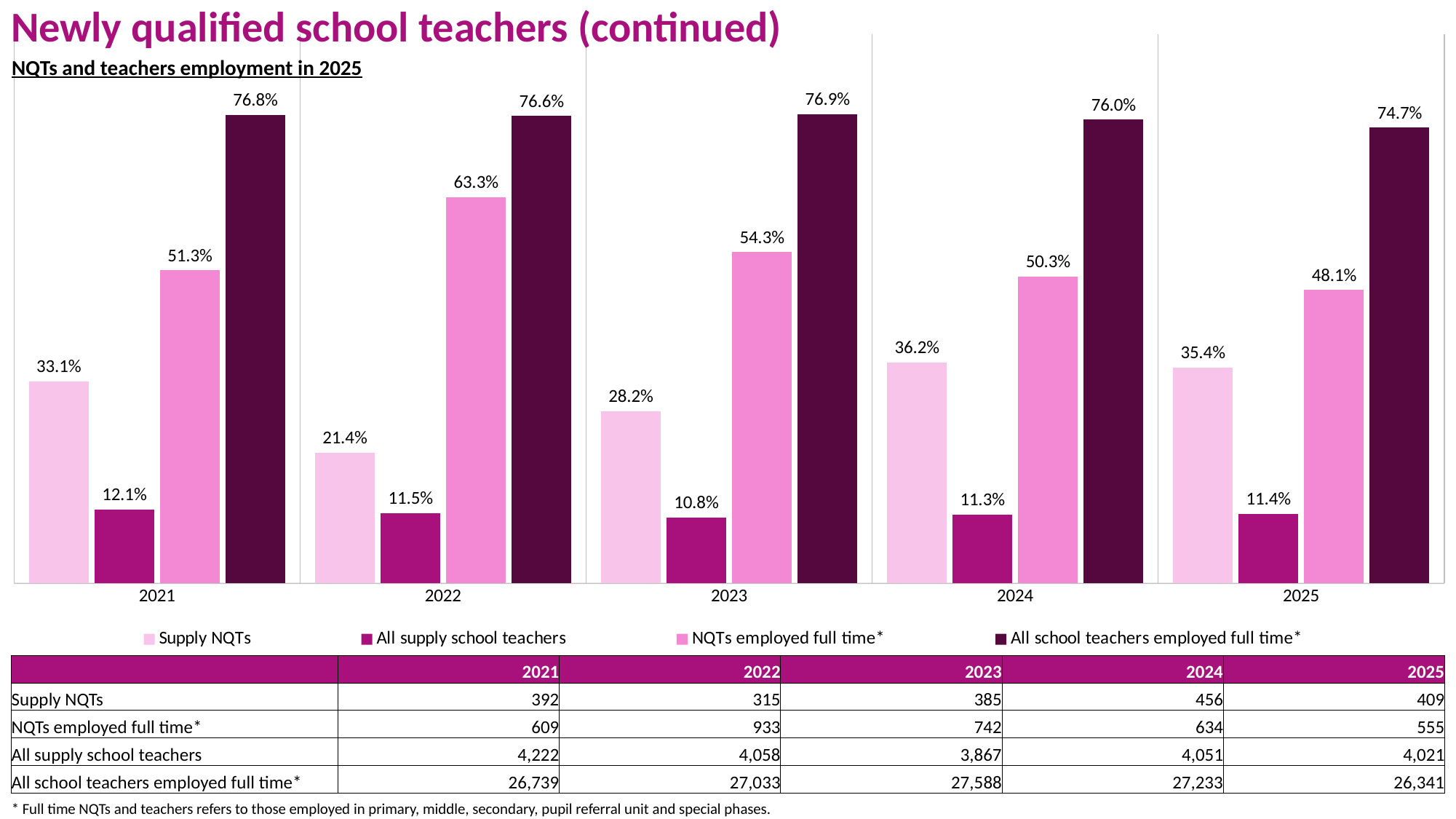
What is the value for NQTs employed full time in 2022? 63.3% Does the NQTs employed full time value rise or fall from 2022 to 2025? Fall How many series does the chart legend list? 4 What is the value for Supply NQTs in 2021? 33.1% In which year is the Supply NQTs value highest? 2024 Which is larger: Supply NQTs in 2024 or Supply NQTs in 2025? 2024 What kind of chart is shown on the slide? Bar chart What is the difference between the NQTs employed full time values for 2022 and 2021? 12.0 percentage points In which year is the NQTs employed full time value lowest? 2025 How many years are shown on the x axis of the chart? 5 What is the value for All school teachers employed full time in 2025? 74.7% What is the value for All supply school teachers in 2023? 10.8%